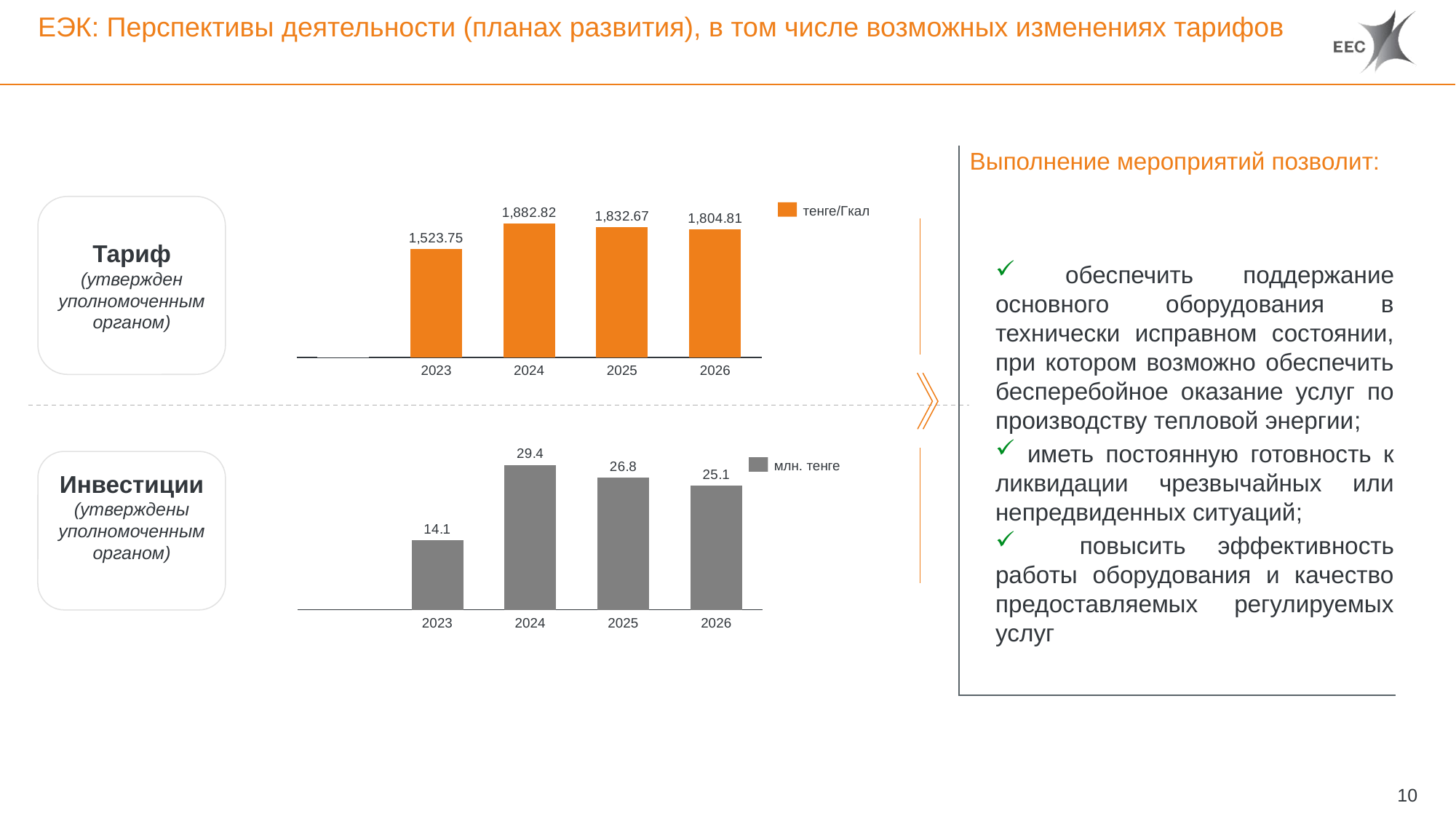
In the top chart (Тариф), what is the difference between the 2024 and 2023 values? 359.07 In the top chart (Тариф), what is the value for 2023? 1,523.75 How many years are shown on the x axis of the bottom chart (Инвестиции)? 4 In the top chart (Тариф), what unit does the legend show? тенге/Гкал In the top chart (Тариф), which year has the lowest value? 2023 In the top chart (Тариф), which year has the highest value? 2024 In the bottom chart (Инвестиции), what is the difference between the 2024 and 2023 values? 15.3 In the top chart (Тариф), what is the value for 2024? 1,882.82 What type of chart is the bottom chart (Инвестиции)? Bar chart In the bottom chart (Инвестиции), which is larger, the value for 2025 or 2026? 2025 In the bottom chart (Инвестиции), what is the value for 2025? 26.8 In the bottom chart (Инвестиции), which year has the highest value? 2024